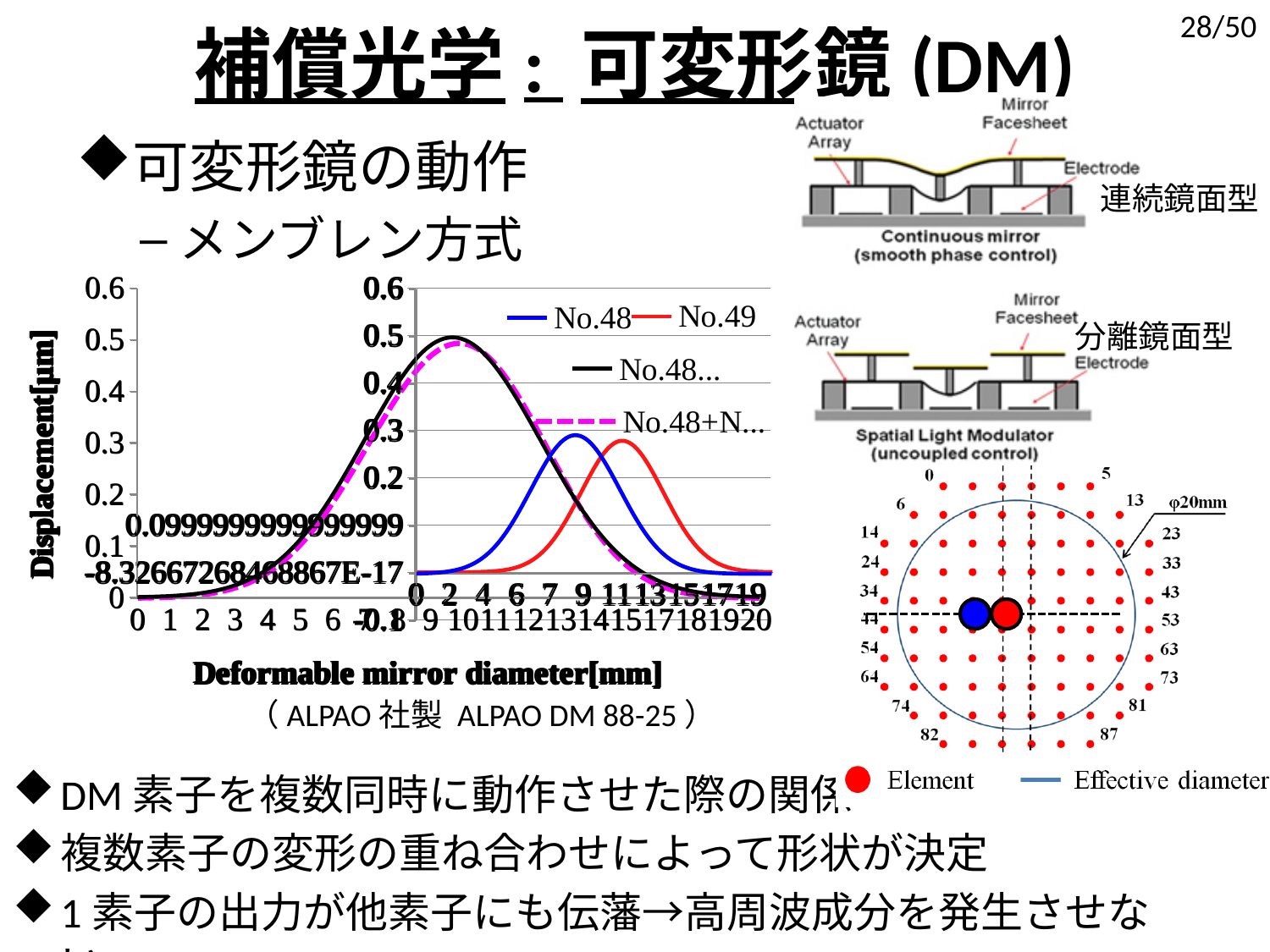
What kind of chart is shown on the left of the slide? line chart Is the peak value of the No.49 (red) curve greater or less than 0.2? greater What is the highest value shown on the y axis of the line chart? 0.6 Is the peak value of the No.48 (blue) curve greater or less than 0.4? less Is the peak value of the black No.48... curve greater or less than 0.4? greater Which reaches a higher peak displacement, the magenta dashed No.48+N... curve or the red No.49 curve? the magenta dashed No.48+N... curve What is the label of the x axis of the line chart? Deformable mirror diameter[mm] Which reaches a higher peak displacement, the black No.48... curve or the blue No.48 curve? the black No.48... curve What is the label of the y axis of the line chart? Displacement[μm] How many series does the legend of the line chart list? 4